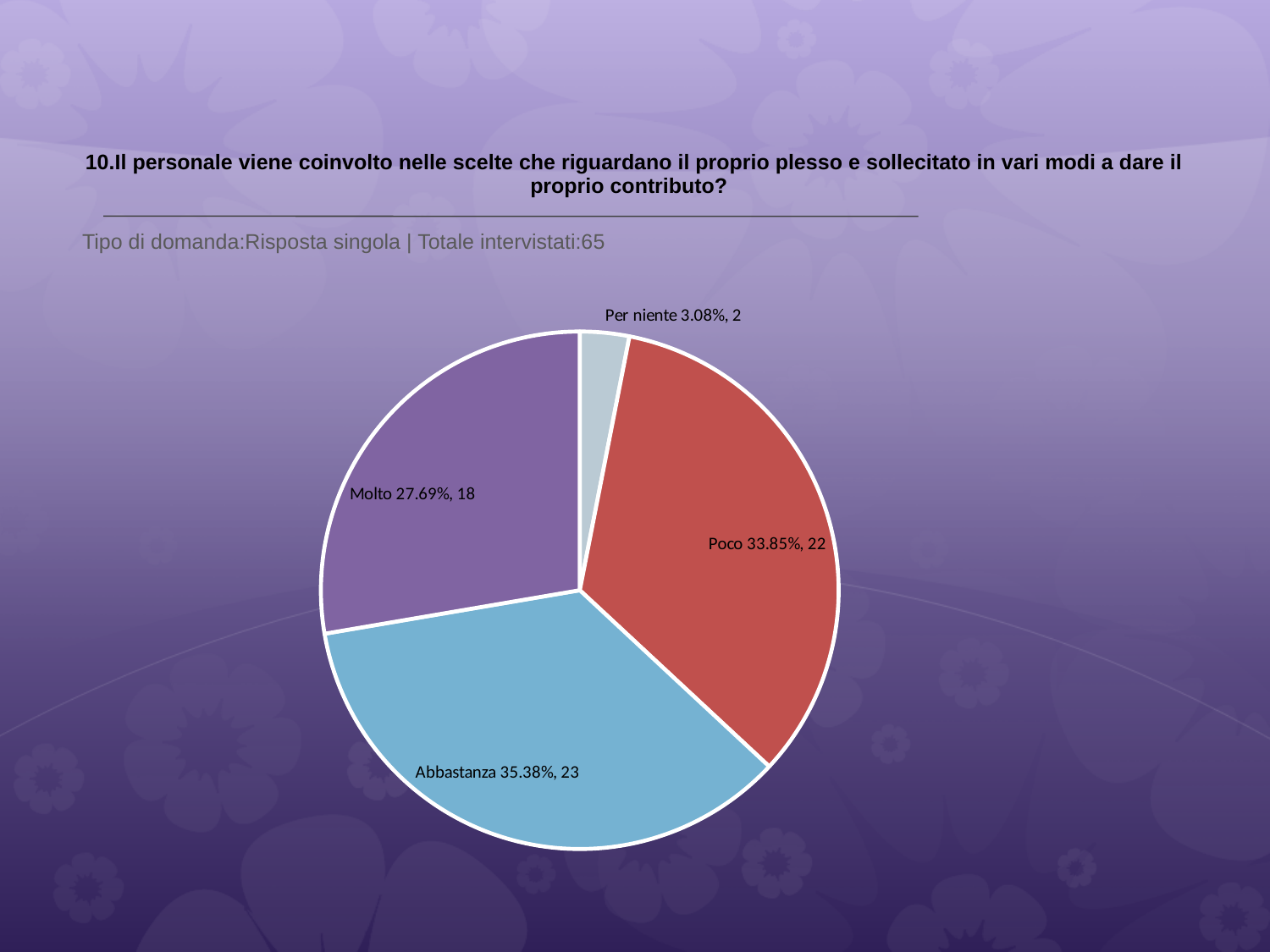
Which has a larger count, 'Molto' or 'Per niente'? Molto What percentage is shown for the 'Molto' slice? 27.69% What colour is the 'Poco' slice? red What percentage is shown for the 'Abbastanza' slice? 35.38% Which category has the largest slice? Abbastanza How many slices does the pie chart have? 4 Which category has the smallest slice? Per niente What is the count for the 'Poco' slice? 22 What is the difference in count between 'Poco' and 'Molto'? 4 What is the count for the 'Per niente' slice? 2 What is the total number of respondents (Totale intervistati) stated on the slide? 65 What kind of chart is shown on the slide? pie chart